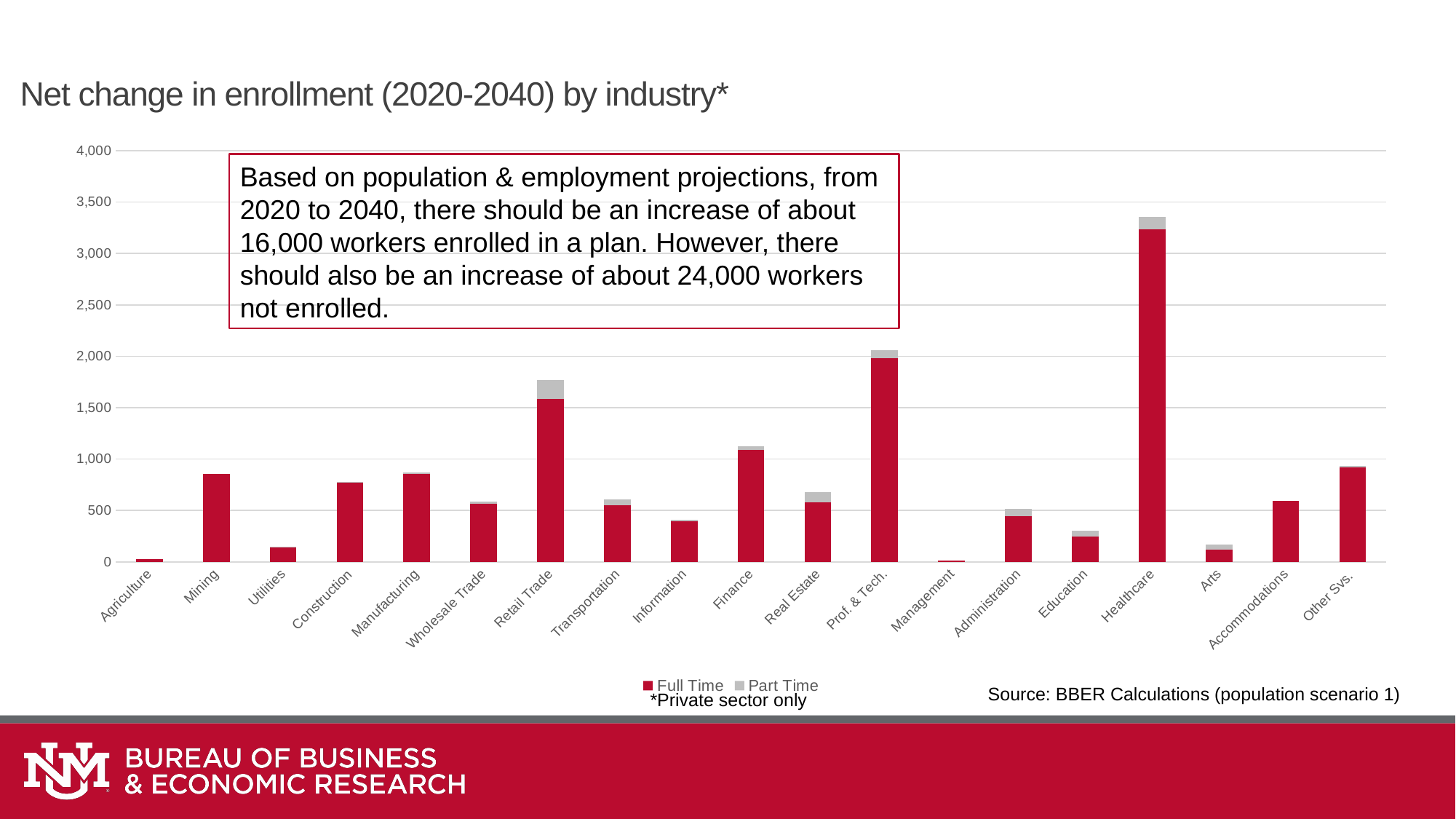
Which has a larger total net change in enrollment, Retail Trade or Finance? Retail Trade Is the total value for Retail Trade greater or less than 1,500? greater What kind of chart is shown on the slide? Stacked bar chart What are the two series named in the chart's legend? Full Time and Part Time Is the total value for Finance greater or less than 1,000? greater Which has a larger net change in enrollment, Mining or Utilities? Mining Is the value for Information greater or less than 500? less How many series does the chart's legend list? 2 Which industry has the highest total net change in enrollment? Healthcare How many industries are shown on the x axis of the chart? 19